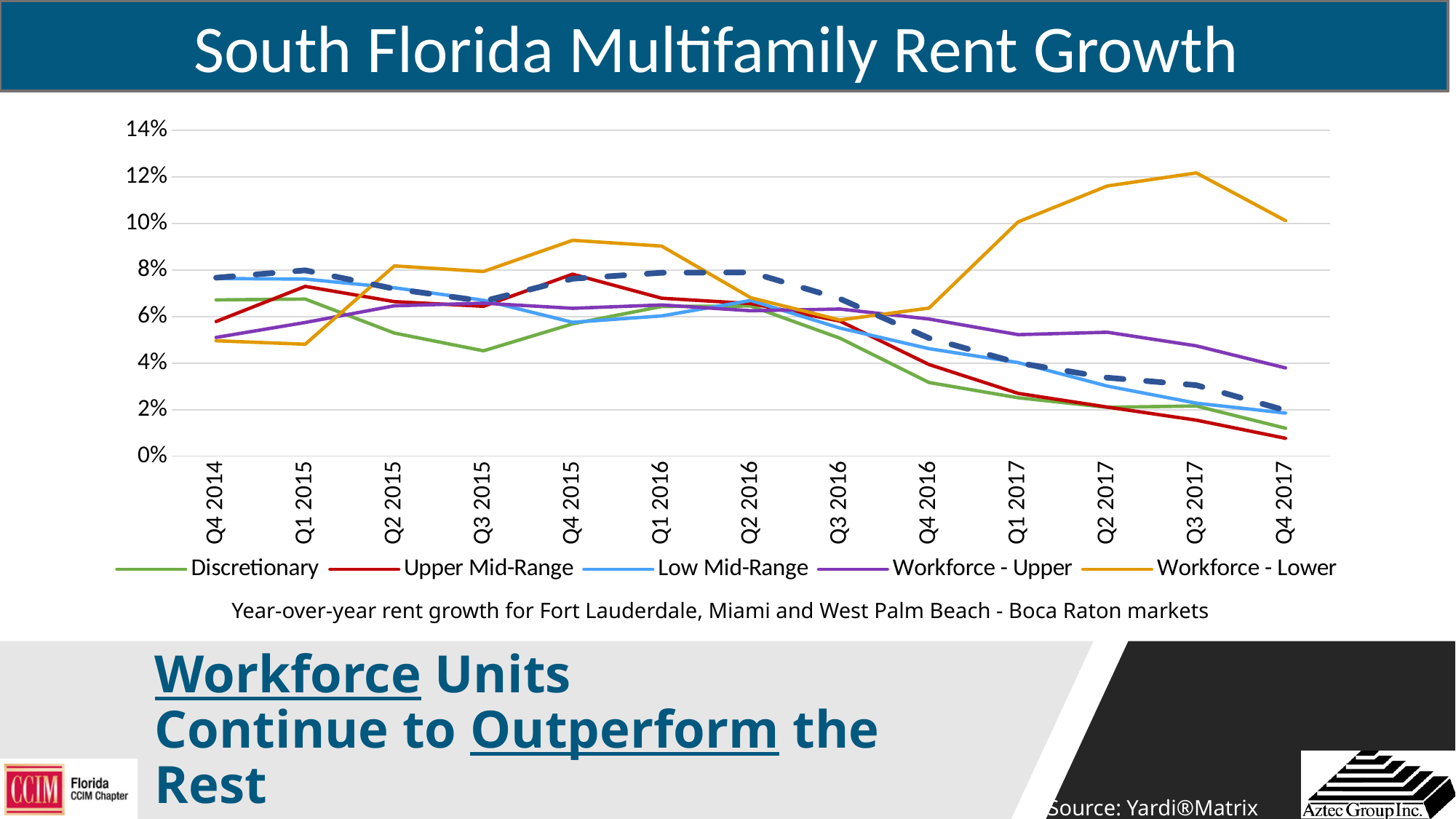
Which series has the highest value in Q4 2017? Workforce - Lower Is the value for Workforce - Upper in Q2 2017 greater or less than 4%? greater What is the title of the chart? South Florida Multifamily Rent Growth In Q1 2017, which is larger: Workforce - Lower or Discretionary? Workforce - Lower Which series has the lowest value in Q4 2017? Upper Mid-Range Which series has the highest value in Q3 2017? Workforce - Lower How many series does the legend list? 5 What kind of chart is shown on the slide? line chart Does the Upper Mid-Range series rise or fall from Q4 2015 to Q4 2017? fall How many quarters are plotted along the x axis? 13 Is the value for Workforce - Lower in Q3 2017 greater or less than 10%? greater Is the value for Discretionary in Q3 2015 greater or less than 6%? less